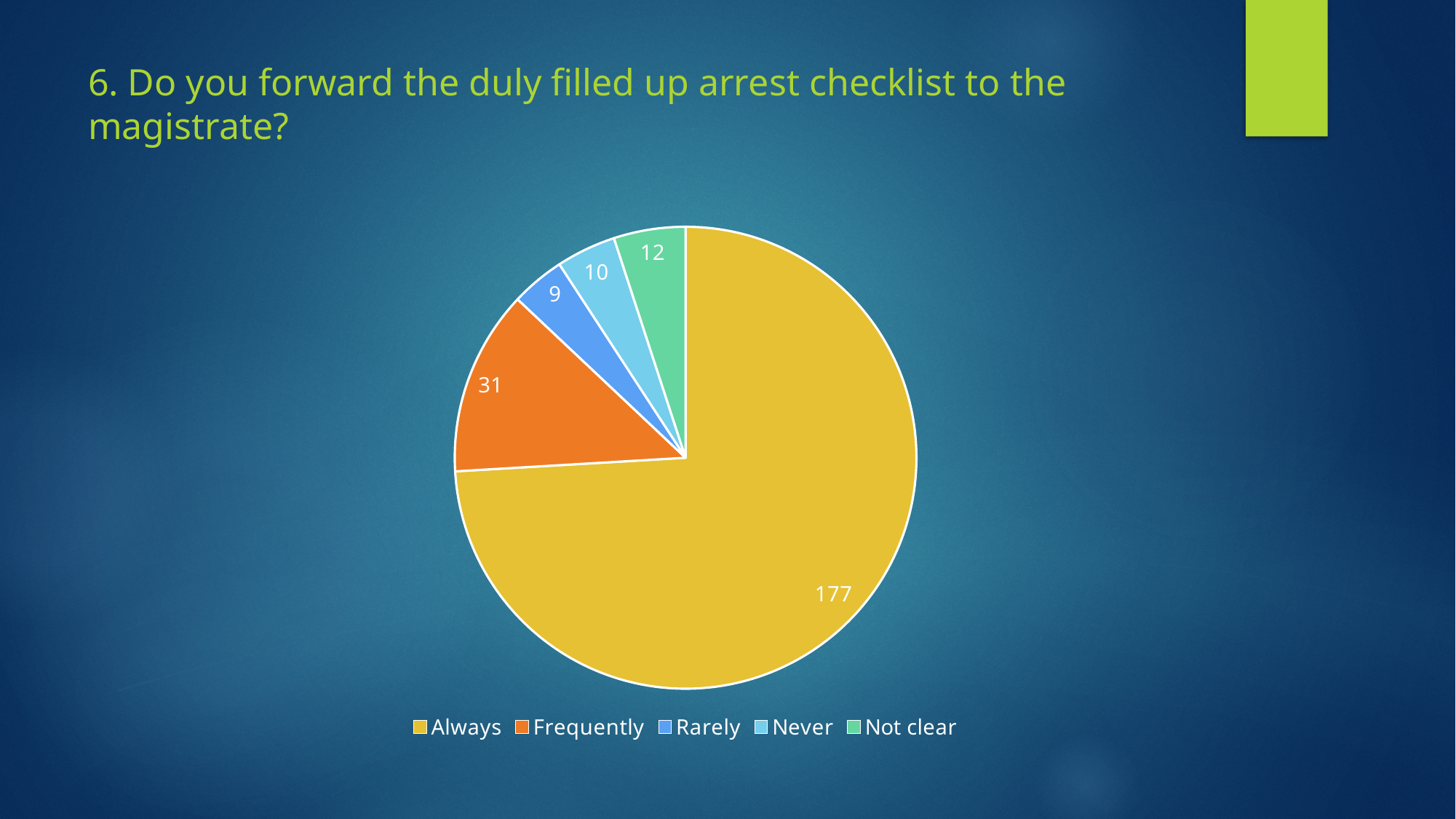
What is the value for Frequently? 31 What is the value for Never? 10 Which is larger, the value for Not clear or the value for Never? Not clear What is the title of the slide containing the chart? 6. Do you forward the duly filled up arrest checklist to the magistrate? What is the difference between the values for Always and Frequently? 146 Which category has the smallest slice? Rarely What is the value for Always? 177 How many categories does the pie chart have? 5 Which category has the largest slice? Always What is the value for Not clear? 12 What type of chart is shown on the slide? Pie chart What is the value for Rarely? 9